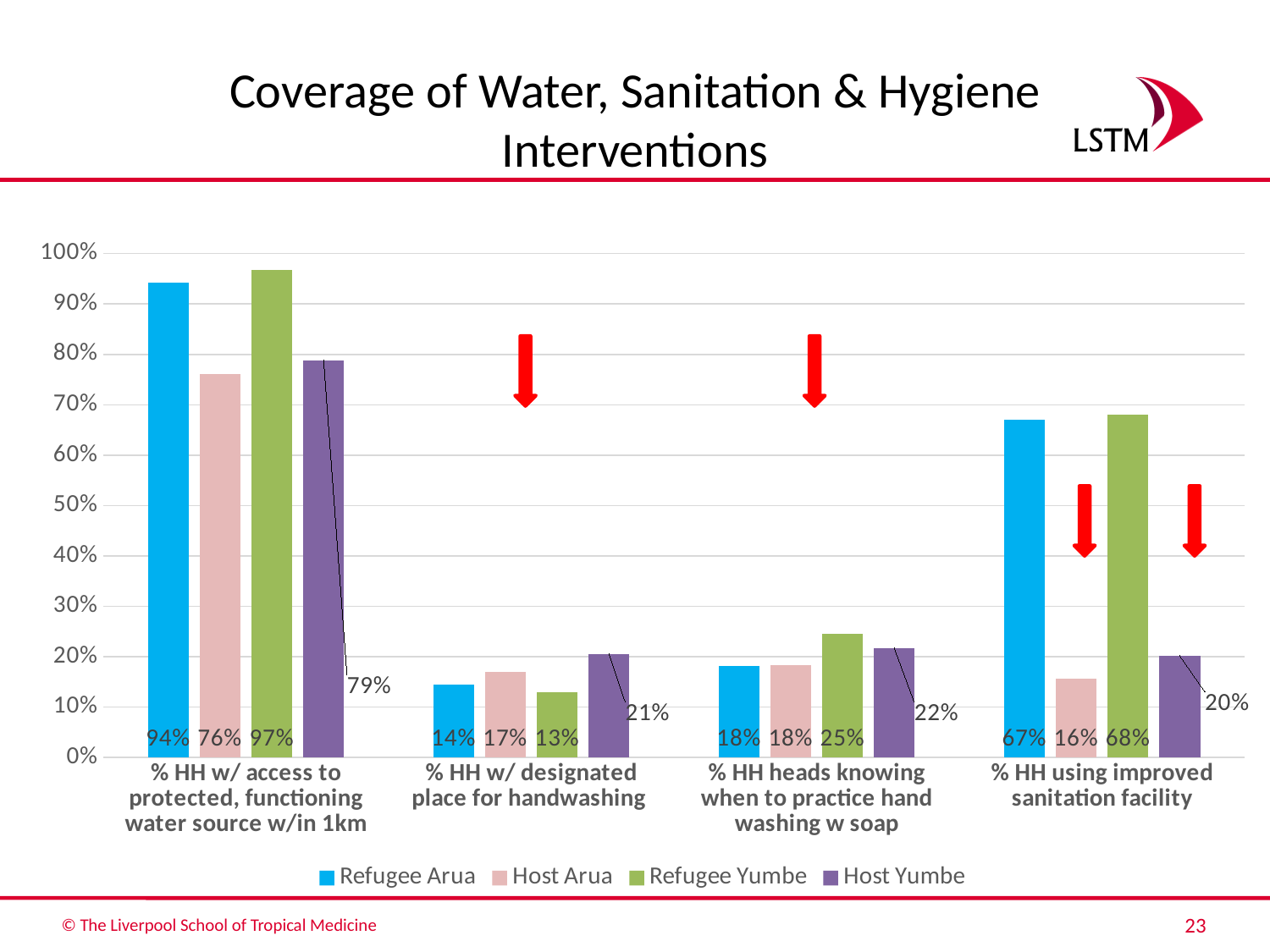
What is the title of the slide containing the chart? Coverage of Water, Sanitation & Hygiene Interventions What kind of chart is shown on the slide? Bar chart What is the difference between the Refugee Arua and Host Arua values in the category '% HH using improved sanitation facility'? 51% How many series does the legend list? 4 Which is larger in the category '% HH w/ access to protected, functioning water source w/in 1km': Host Arua or Host Yumbe? Host Yumbe What is the value for Host Yumbe in the category '% HH heads knowing when to practice hand washing w soap'? 22% How many categories are shown on the x axis? 4 Which series has the lowest value in the category '% HH w/ designated place for handwashing'? Refugee Yumbe What is the value for Host Arua in the category '% HH w/ designated place for handwashing'? 17% What is the value for Refugee Yumbe in the category '% HH w/ access to protected, functioning water source w/in 1km'? 97% Which series has the highest value in the category '% HH using improved sanitation facility'? Refugee Yumbe What is the value for Refugee Arua in the category '% HH using improved sanitation facility'? 67%